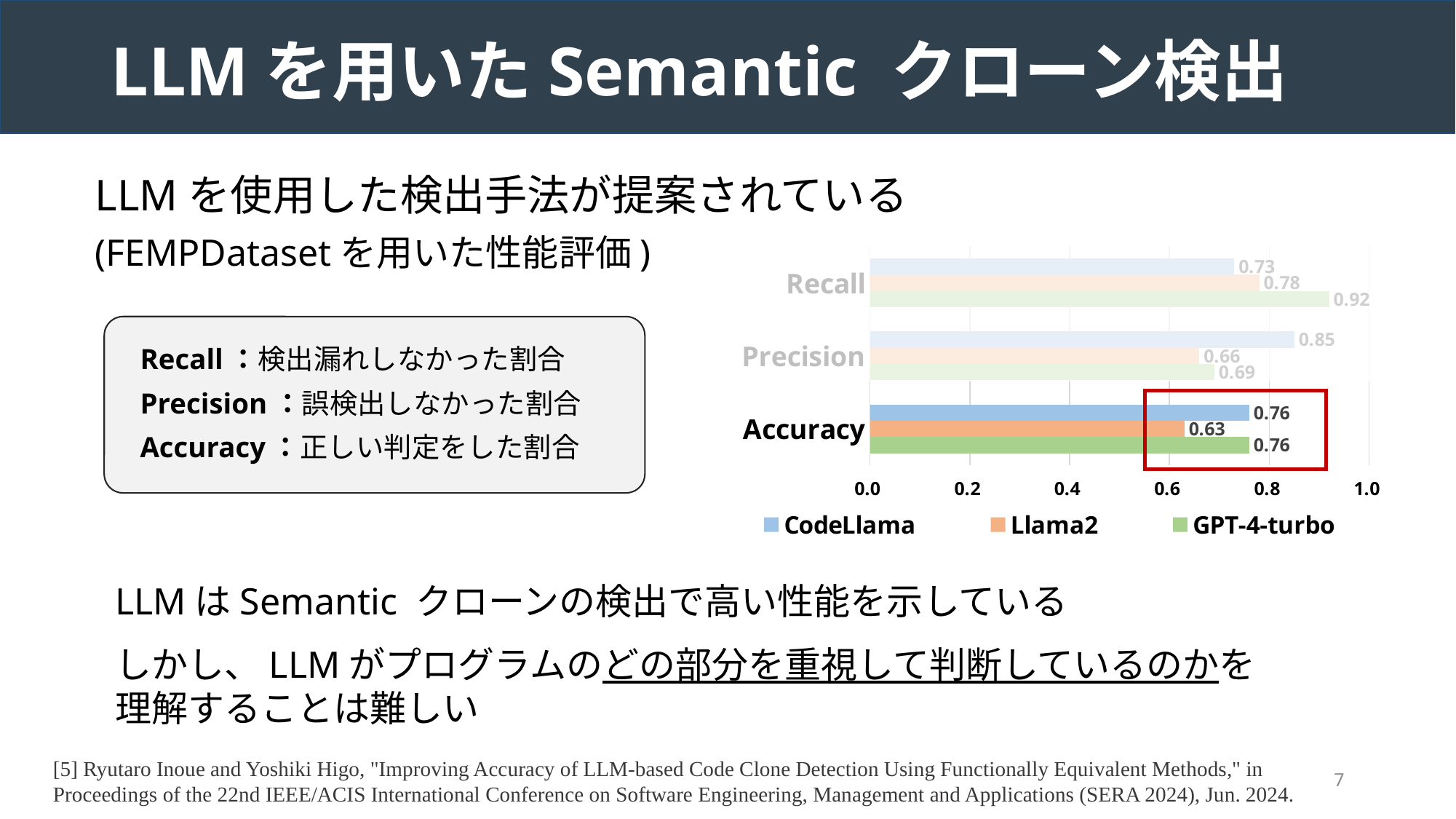
Which model has the highest Recall? GPT-4-turbo What is the difference between the Recall of GPT-4-turbo and the Recall of CodeLlama? 0.19 Which is larger: the Precision of CodeLlama or the Precision of GPT-4-turbo? Precision of CodeLlama What is the Recall value for GPT-4-turbo? 0.92 Which model has the lowest Precision? Llama2 What is the Precision value for CodeLlama? 0.85 What is the Recall value for Llama2? 0.78 How many metric categories are shown on the chart? 3 Which category on the chart is highlighted with a red box? Accuracy How many series does the legend list? 3 What is the Accuracy value for Llama2? 0.63 What kind of chart is shown on the slide? Bar chart